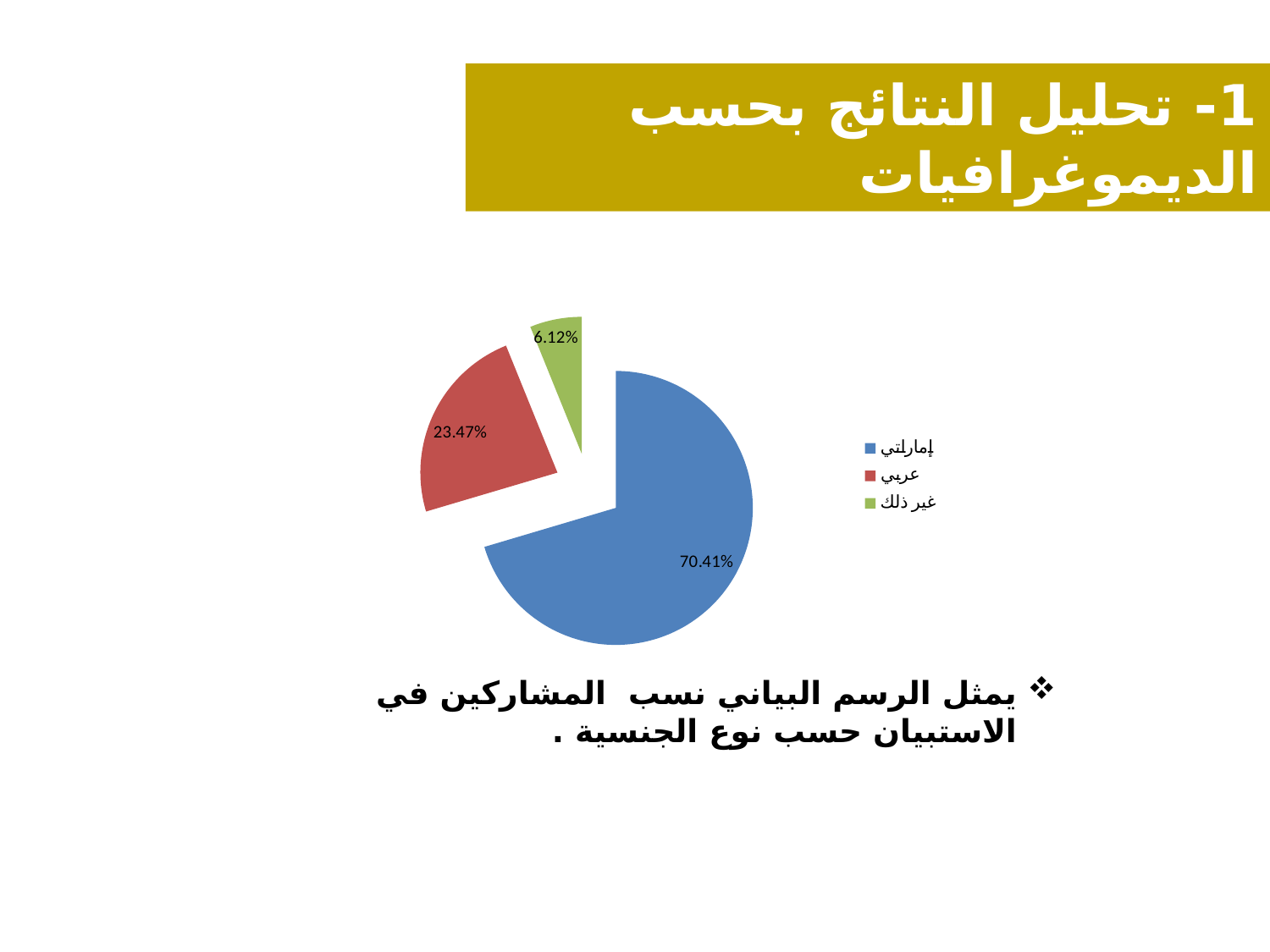
Which category has the smallest slice in the pie chart? غير ذلك What is the difference in percentage points between the إماراتي slice and the عربي slice? 46.94 Which category has the largest slice in the pie chart? إماراتي What percentage is shown for the غير ذلك slice of the pie chart? 6.12% What is the difference in percentage points between the عربي slice and the غير ذلك slice? 17.35 How many entries does the legend of the pie chart list? 3 What percentage of the pie chart is labelled for the إماراتي slice? 70.41% Which slice is larger, عربي or غير ذلك? عربي What percentage is shown for the عربي slice of the pie chart? 23.47% What type of chart is shown on the slide? pie chart How many slices does the pie chart have? 3 What colour is the slice representing إماراتي in the pie chart? blue